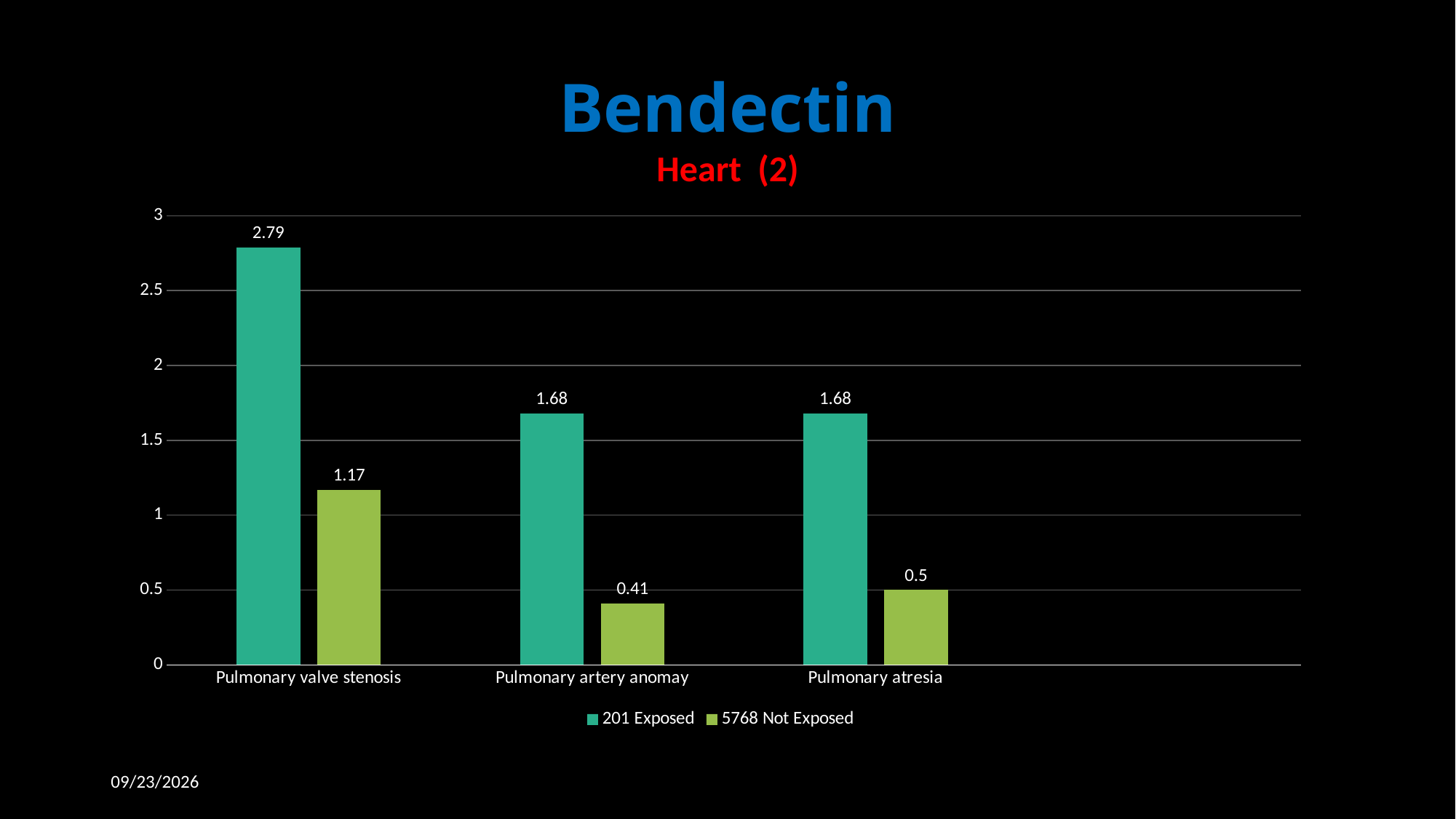
How many series does the legend list? 2 What is the value for 201 Exposed for Pulmonary valve stenosis? 2.79 What is the value for 5768 Not Exposed for Pulmonary atresia? 0.5 What is the value for 201 Exposed for Pulmonary atresia? 1.68 Which category has the lowest value for 5768 Not Exposed? Pulmonary artery anomay What is the subtitle shown in red below the main title? Heart (2) Which is larger for Pulmonary atresia: the 201 Exposed value or the 5768 Not Exposed value? 201 Exposed What is the difference between the 201 Exposed and 5768 Not Exposed values for Pulmonary valve stenosis? 1.62 How many categories are shown on the x axis? 3 What kind of chart is shown on the slide? Bar chart Which category has the highest value for 201 Exposed? Pulmonary valve stenosis What is the value for 5768 Not Exposed for Pulmonary artery anomay? 0.41